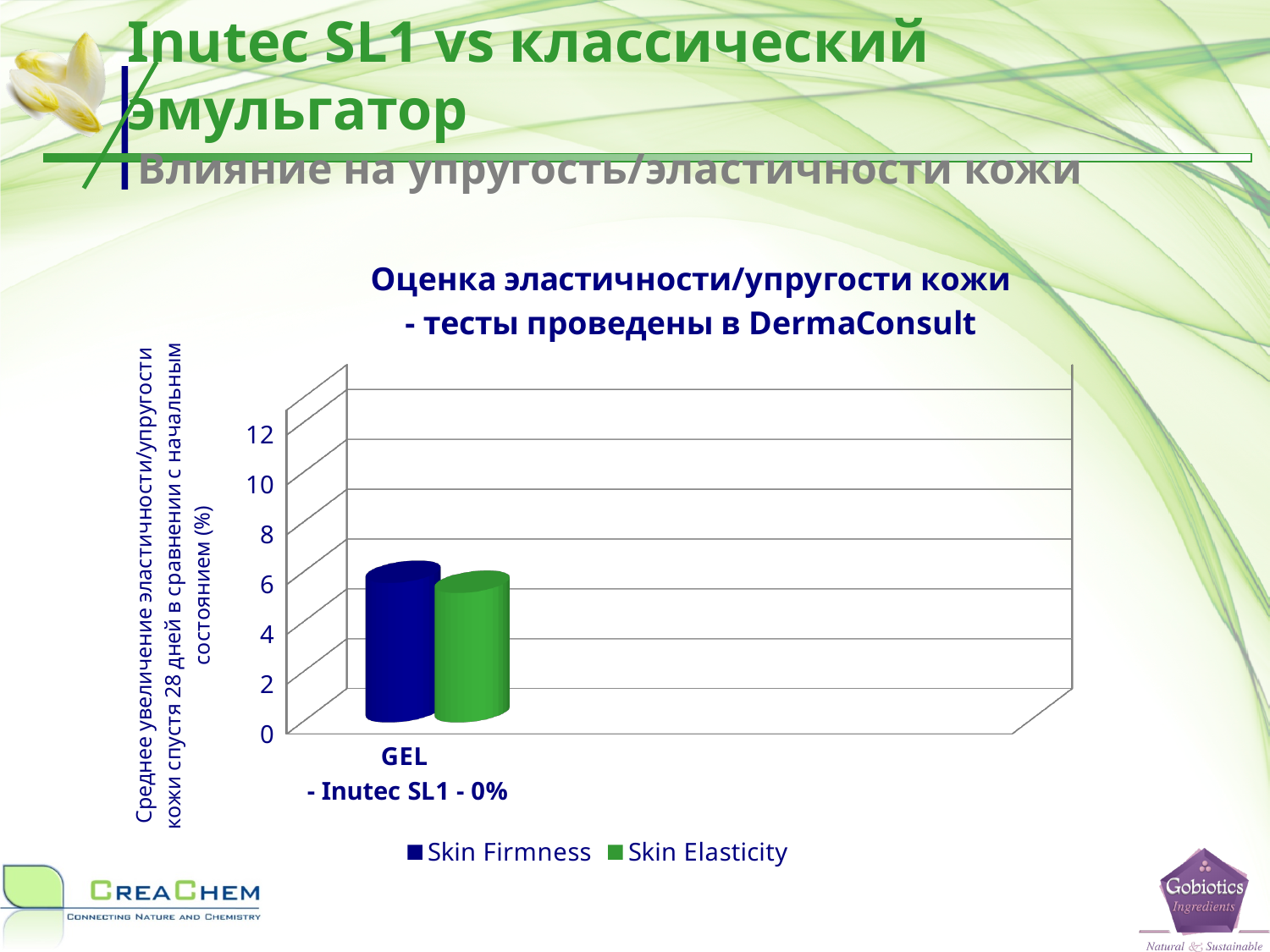
How many categories are shown on the x axis of the chart? 1 Is the value for Skin Elasticity greater or less than 8? less Is the value for Skin Firmness greater or less than 4? greater What kind of chart is shown on the slide? bar chart Which series is shown in blue in the chart? Skin Firmness How many series does the chart legend list? 2 What is the category label on the x axis of the chart? GEL - Inutec SL1 - 0% Is the value for Skin Elasticity greater or less than 2? greater What are the two series named in the chart legend? Skin Firmness and Skin Elasticity